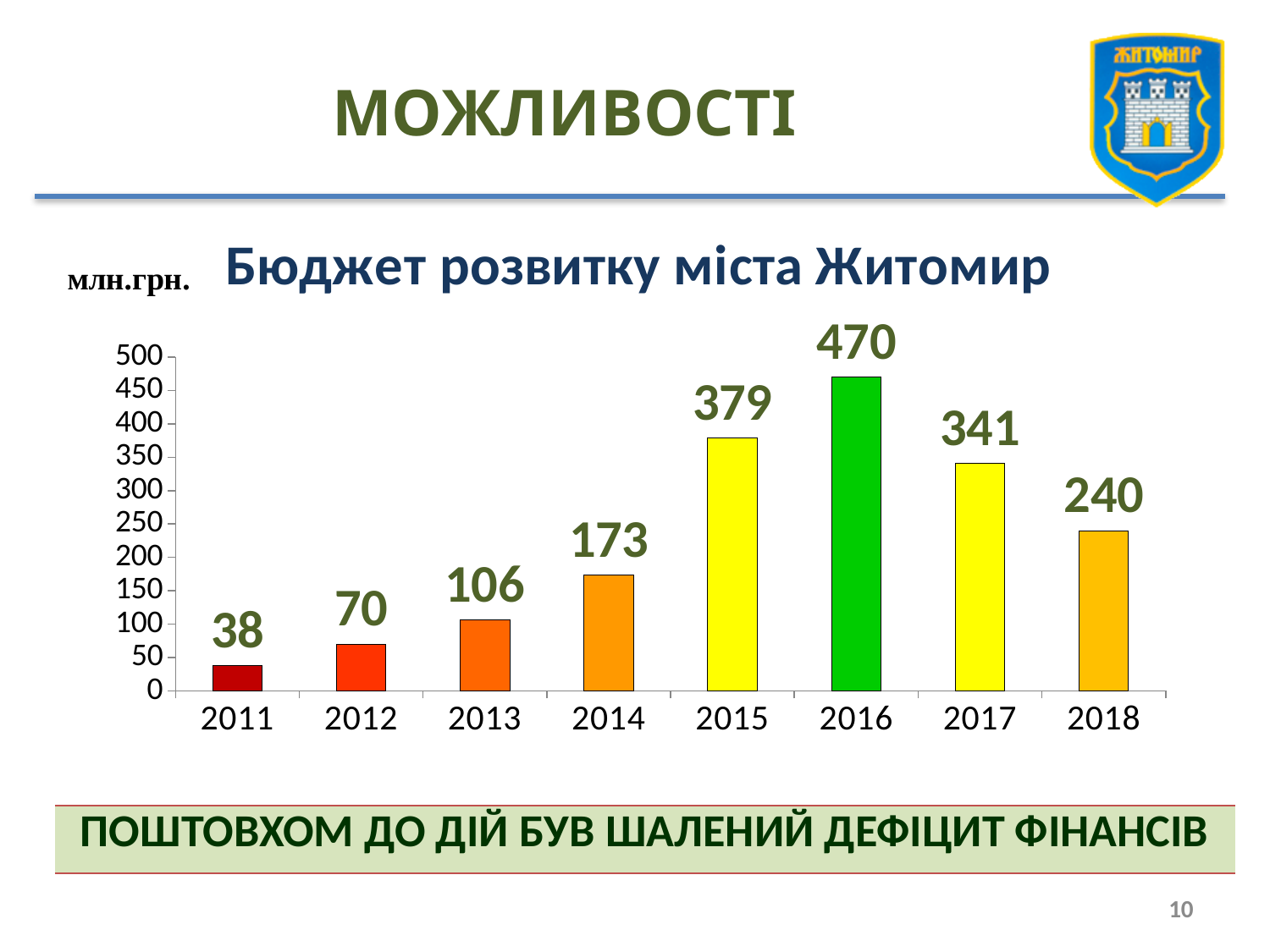
How many years are shown on the x axis? 8 What kind of chart is this? bar chart Which is larger, the value for 2015 or the value for 2017? 2015 What is the difference between the values for 2015 and 2014? 206 What is the difference between the values for 2016 and 2017? 129 Which year has the lowest value? 2011 What is the value for 2016? 470 Which year has the highest value? 2016 What is the value for 2011? 38 Is the value for 2014 greater or less than 200? less What is the title of the chart? Бюджет розвитку міста Житомир What is the value for 2018? 240